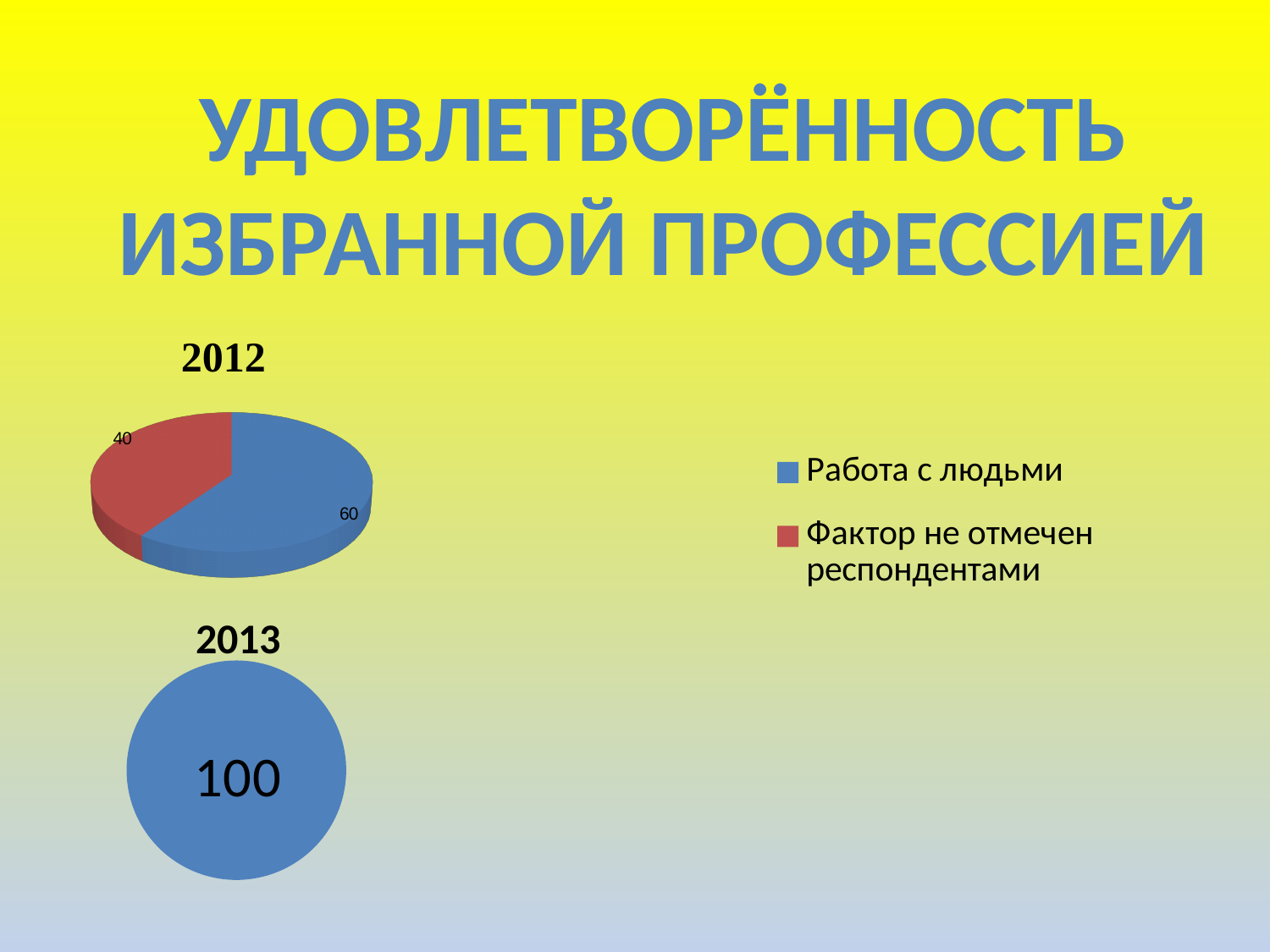
In the 2012 chart, what share of the pie does Работа с людьми take? 60% Which colour represents Фактор не отмечен респондентами in the legend? Red In the 2012 chart, which is larger: Работа с людьми or Фактор не отмечен респондентами? Работа с людьми What kind of chart is the 2012 chart? Pie chart In the 2012 chart, what is the value for Работа с людьми? 60 How many slices does the 2012 chart have? 2 In the 2012 chart, which category has the smallest slice? Фактор не отмечен респондентами How many entries does the legend list? 2 In the 2013 chart, what value is shown for Работа с людьми? 100 In the 2012 chart, what is the value for Фактор не отмечен респондентами? 40 In the 2012 chart, what is the difference between the values for Работа с людьми and Фактор не отмечен респондентами? 20 In the 2012 chart, which category has the largest slice? Работа с людьми